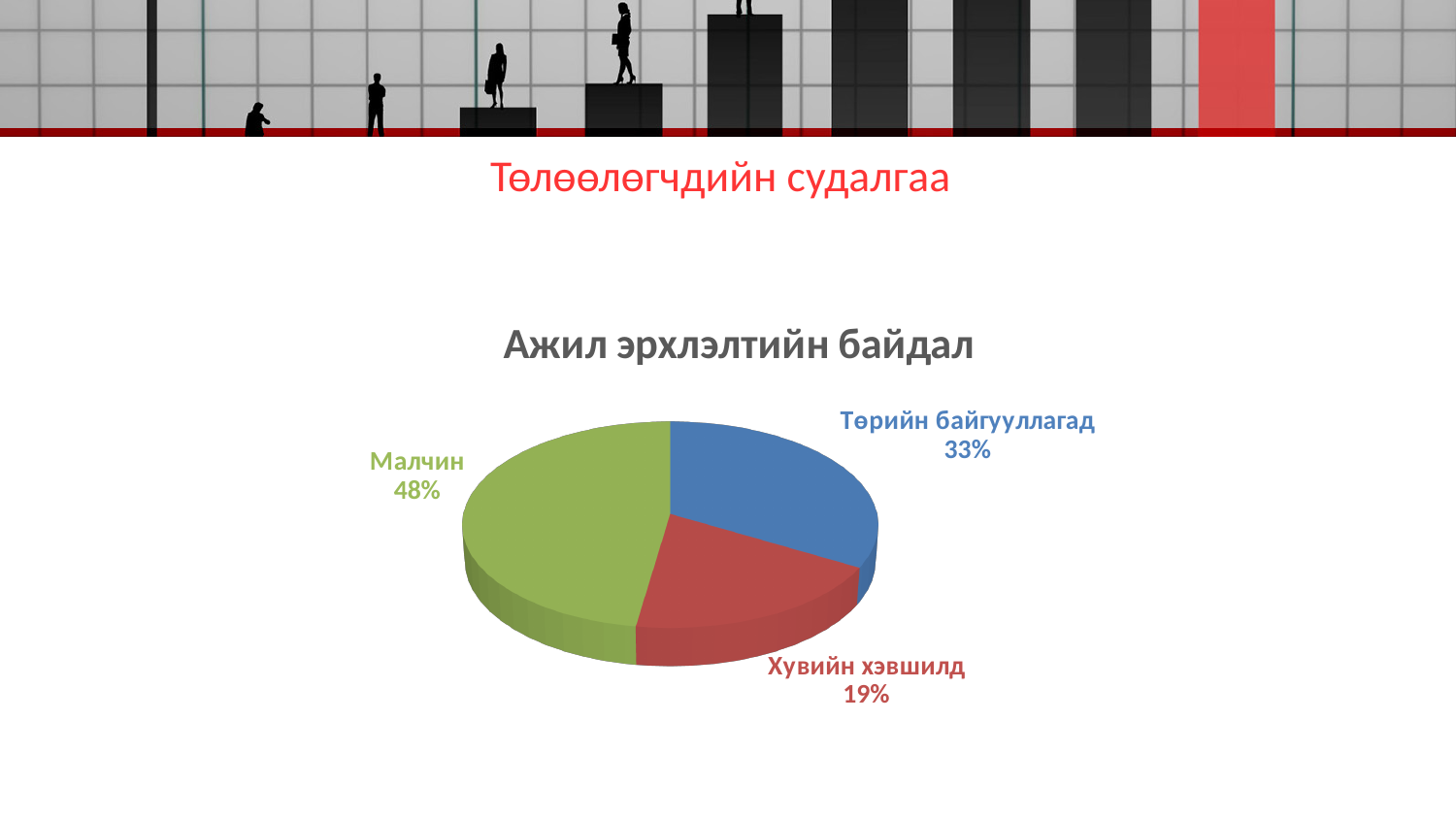
Which category has the smallest slice of the pie? Хувийн хэвшилд What share of the pie does Төрийн байгууллагад represent? 33% What share of the pie does Хувийн хэвшилд represent? 19% What is the difference in percentage points between Төрийн байгууллагад and Хувийн хэвшилд? 14 Which category has the largest slice of the pie? Малчин How many categories are shown in the pie chart? 3 What kind of chart is shown on the slide? Pie chart Which is larger, the share for Төрийн байгууллагад or the share for Хувийн хэвшилд? Төрийн байгууллагад What share of the pie does Малчин represent? 48% What is the title of the chart? Ажил эрхлэлтийн байдал What is the difference in percentage points between Малчин and Төрийн байгууллагад? 15 What colour is the slice for Малчин? Green